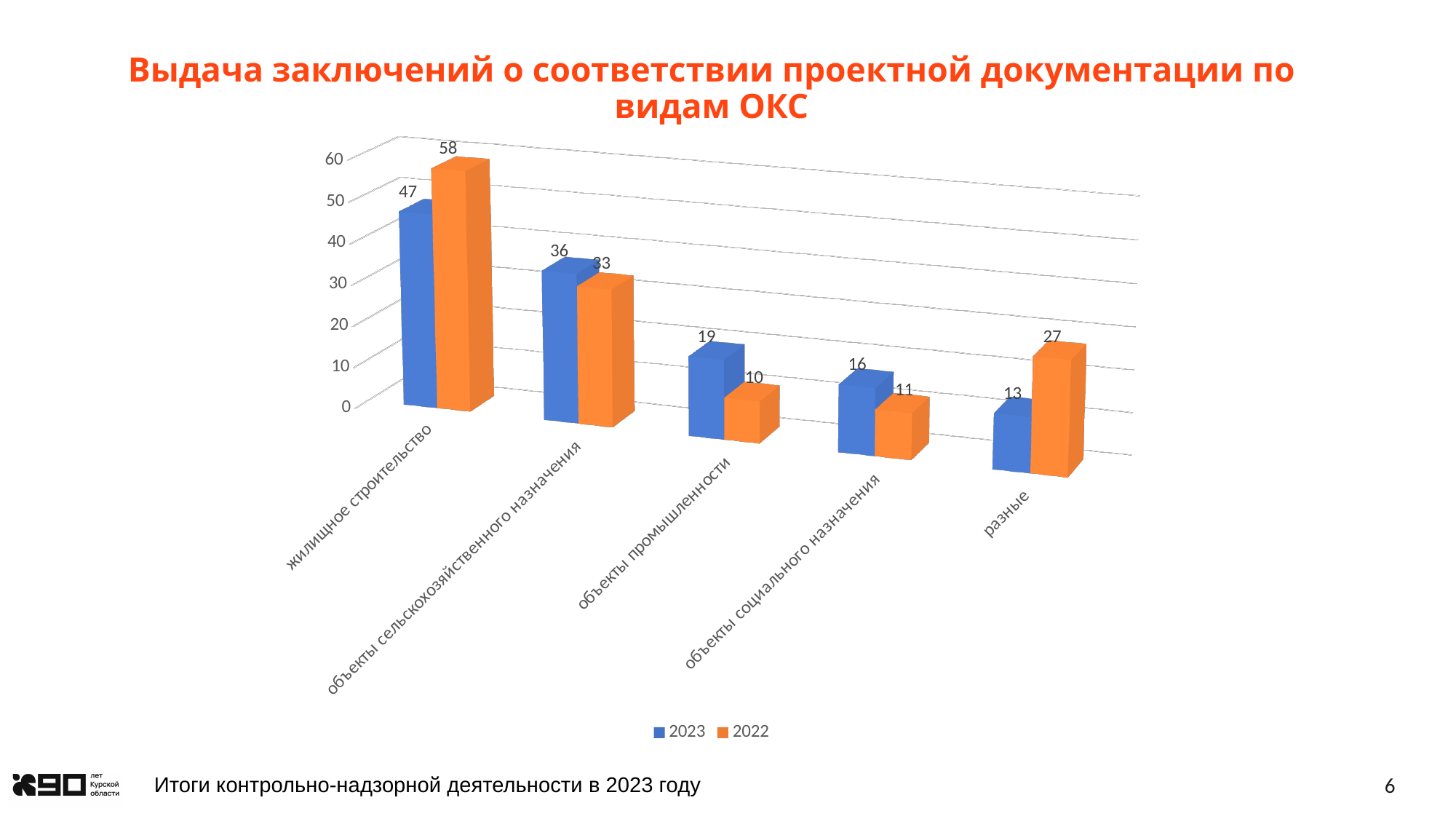
Which is larger for объекты сельскохозяйственного назначения, the 2023 value or the 2022 value? 2023 How many categories are shown on the x axis? 5 How many series does the legend list? 2 Which category has the highest 2022 value? жилищное строительство What is the difference between the 2022 and 2023 values for жилищное строительство? 11 What is the 2022 value for разные? 27 Which colour represents the 2022 series? orange What is the difference between the 2023 and 2022 values for объекты промышленности? 9 Which category has the lowest 2023 value? разные What is the 2023 value for жилищное строительство? 47 What kind of chart is shown on the slide? bar chart What is the 2022 value for объекты промышленности? 10